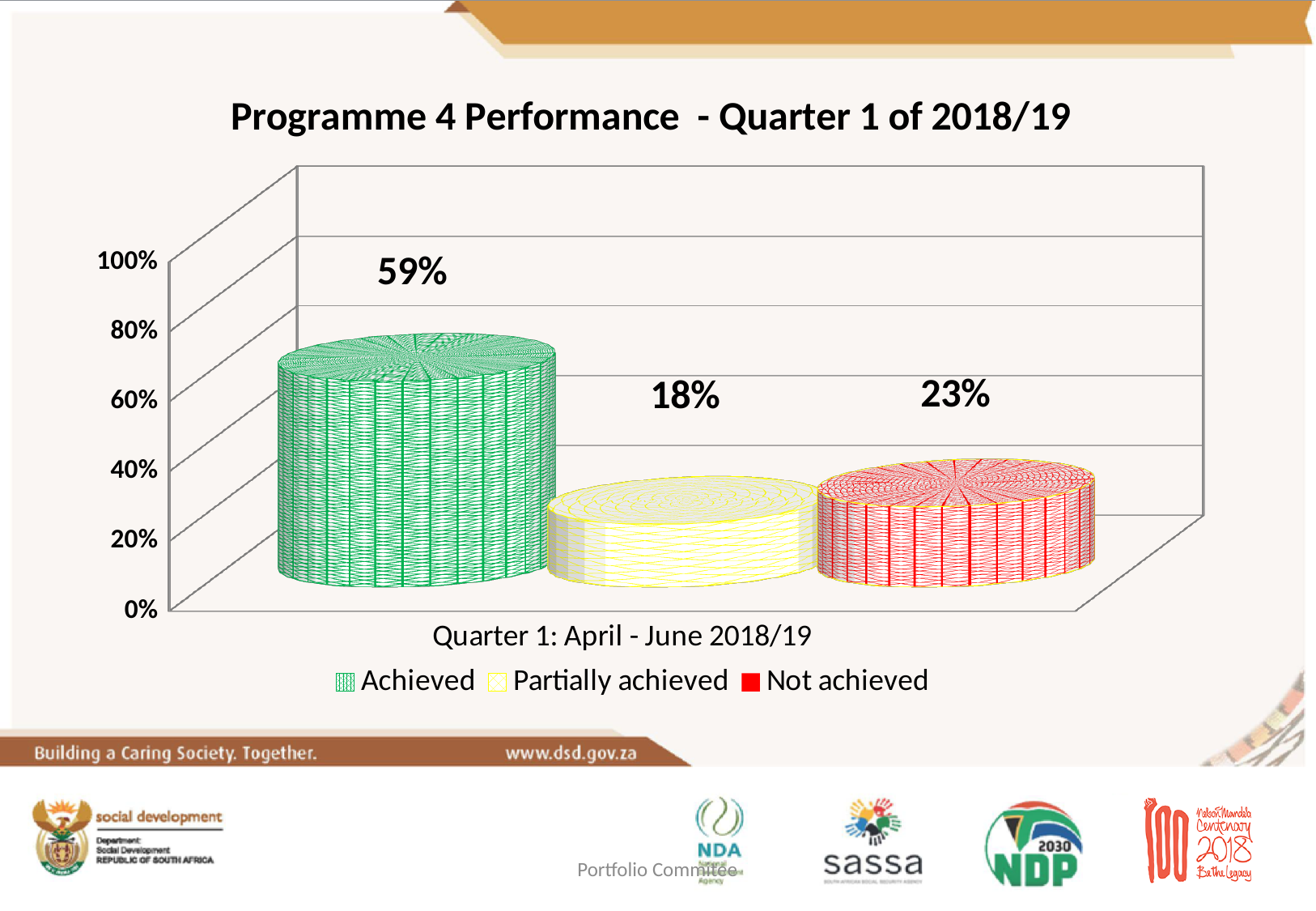
What percentage of Programme 4 targets were partially achieved in Quarter 1 of 2018/19? 18% Which series has the highest value in the chart? Achieved What percentage of Programme 4 targets were not achieved in Quarter 1 of 2018/19? 23% What percentage of Programme 4 targets were achieved in Quarter 1 of 2018/19? 59% What is the difference between the Not achieved and Partially achieved percentages? 5% How many series does the legend list? 3 Which series has the lowest value in the chart? Partially achieved What kind of chart is shown on the slide? Bar chart Is the value for Achieved greater or less than 40%? greater What is the title of the chart? Programme 4 Performance - Quarter 1 of 2018/19 Which is larger, the Not achieved value or the Partially achieved value? Not achieved What is the difference between the Achieved and Not achieved percentages? 36%